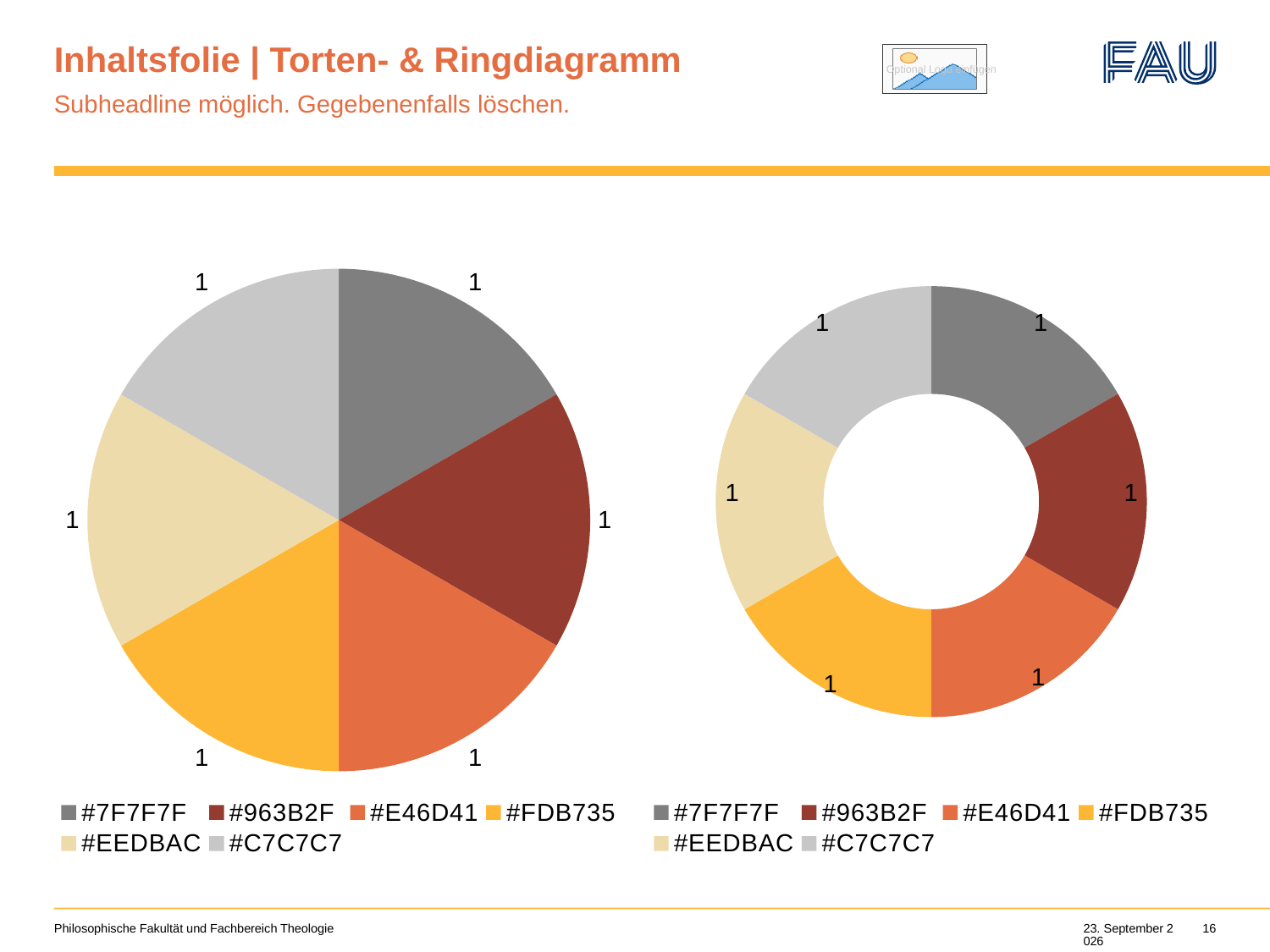
In the doughnut chart on the right, which legend entry is shown in the darkest red-brown colour? #963B2F In the pie chart on the left, what is the difference between the values of the #7F7F7F slice and the #EEDBAC slice? 0 In the pie chart on the left, how many slices are there? 6 What kind of chart is the chart on the left side of the slide? pie chart How many entries does the legend of the pie chart on the left list? 6 In the doughnut chart on the right, how many segments are there? 6 In the pie chart on the left, what is the first entry listed in the legend? #7F7F7F In the pie chart on the left, what is the value of the #C7C7C7 slice? 1 In the pie chart on the left, what is the value of the #963B2F slice? 1 What kind of chart is the chart on the right side of the slide? doughnut chart In the doughnut chart on the right, what is the total of all segment values? 6 In the doughnut chart on the right, what is the value of the #FDB735 segment? 1